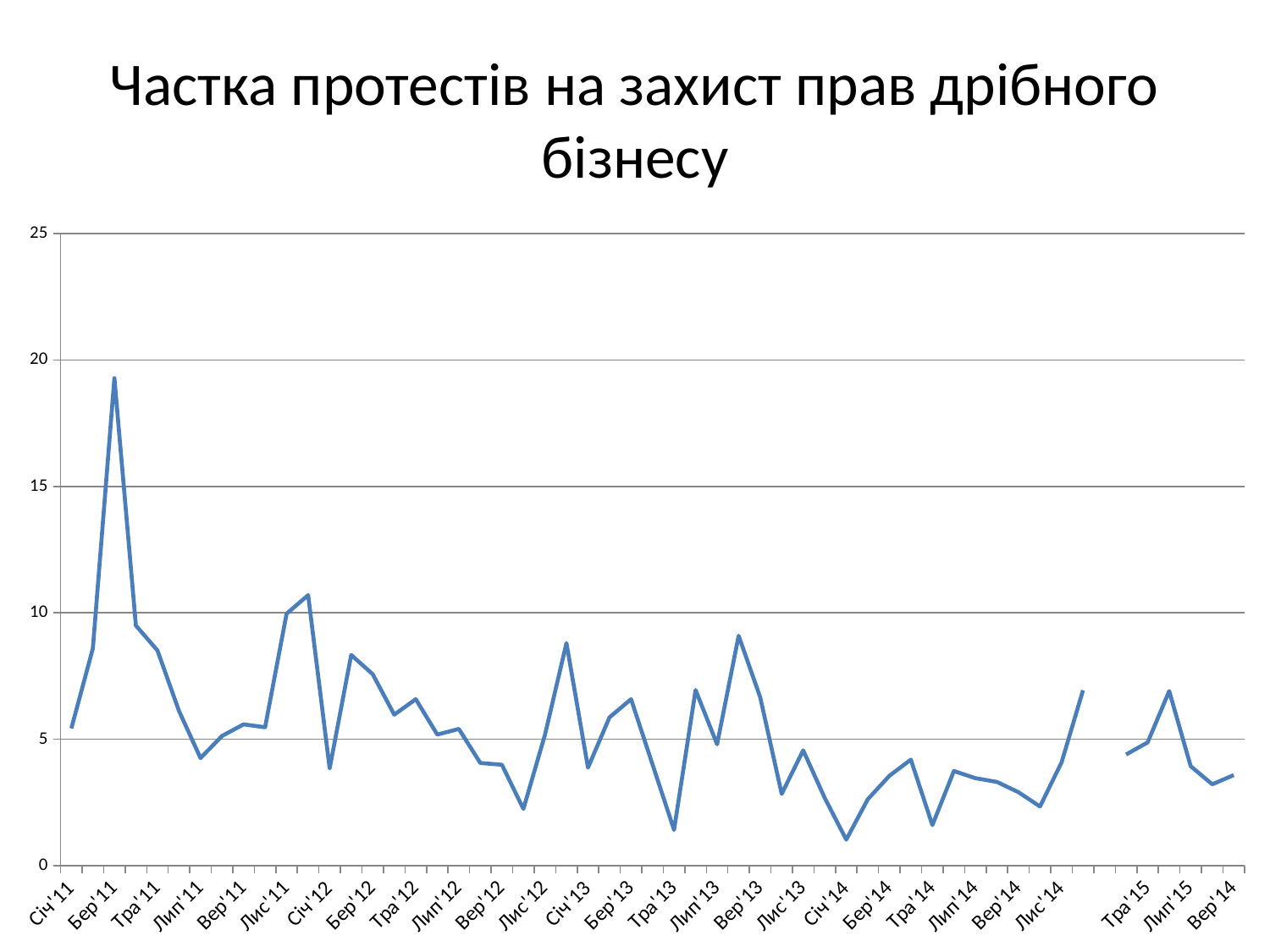
What kind of chart is shown on the slide? line chart Is the value for Бер'11 greater or less than 15? greater Which month has the lowest value on the chart? Січ'14 Which is larger, the value for Бер'11 or the value for Січ'13? Бер'11 What is the title of the chart? Частка протестів на захист прав дрібного бізнесу Which month has the highest value on the chart? Бер'11 Does the value rise or fall between Січ'11 and Бер'11? rise Is the value for Лип'11 greater or less than 5? less Is the value for Тра'13 greater or less than 5? less